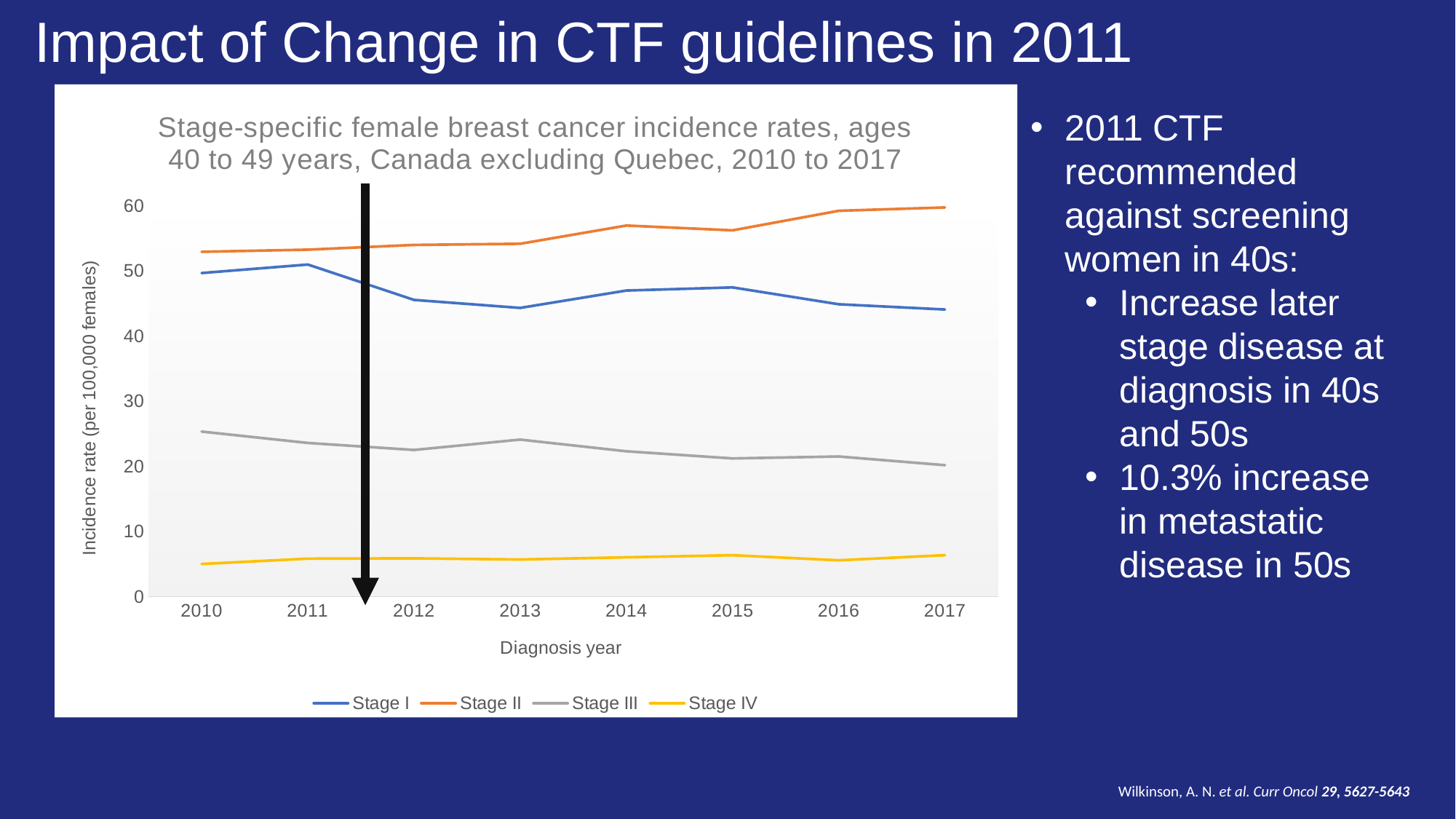
Does the Stage II incidence rate rise or fall from 2010 to 2017? rise How many diagnosis years are plotted along the x axis? 8 How many series does the legend list? 4 Is the value for Stage III in 2010 greater or less than 30? less Which stage has the lowest incidence rate in 2010? Stage IV What is the label of the y axis? Incidence rate (per 100,000 females) Is the value for Stage II in 2017 greater or less than 50? greater Is the value for Stage IV in 2014 greater or less than 10? less What kind of chart is shown on the slide? line chart What is the label of the x axis? Diagnosis year Which stage has the highest incidence rate in 2017? Stage II